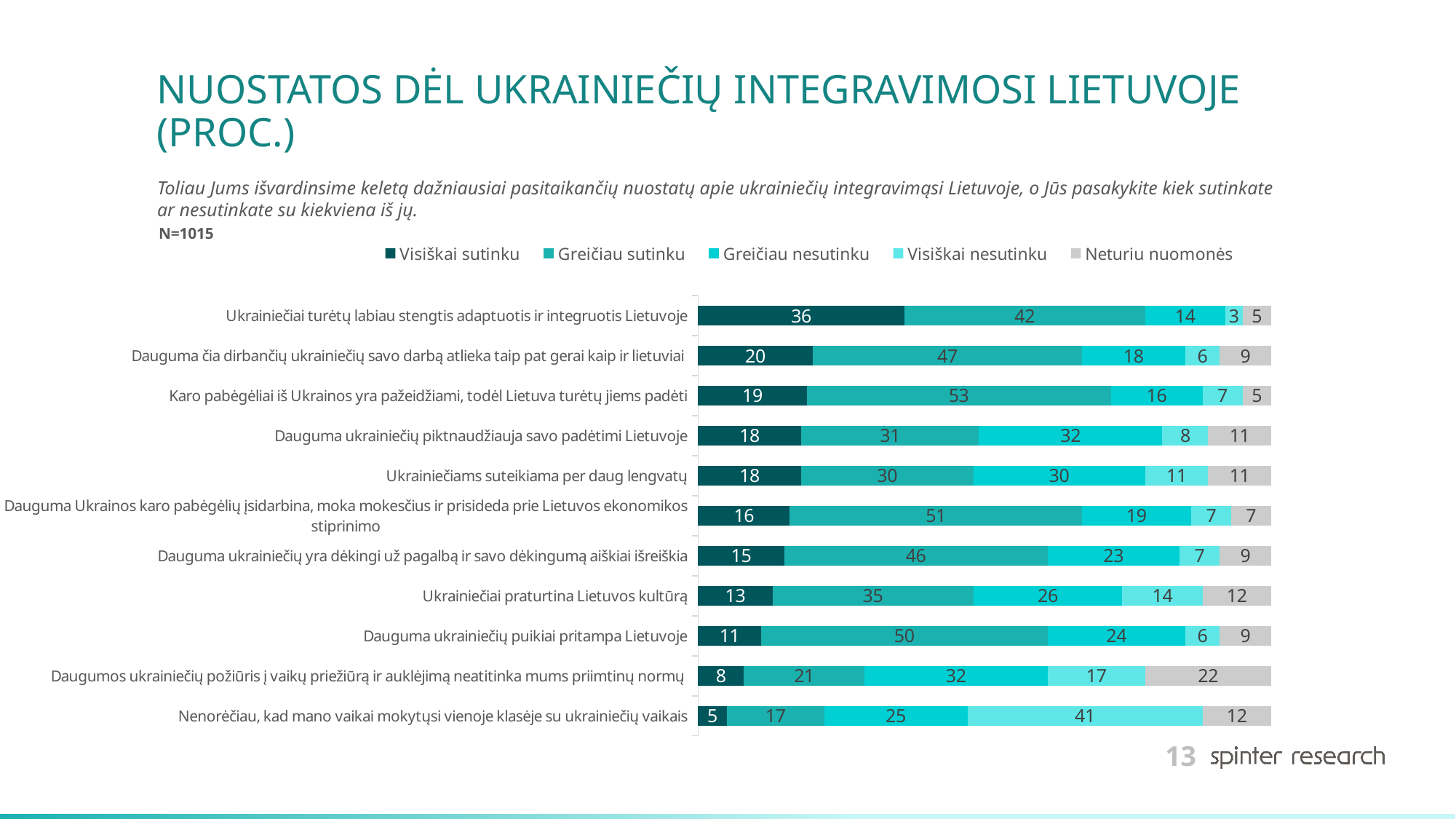
What is the "Greičiau sutinku" value for "Karo pabėgėliai iš Ukrainos yra pažeidžiami, todėl Lietuva turėtų jiems padėti"? 53 Which statement has the highest "Visiškai sutinku" value? Ukrainiečiai turėtų labiau stengtis adaptuotis ir integruotis Lietuvoje What is the "Neturiu nuomonės" value for "Daugumos ukrainiečių požiūris į vaikų priežiūrą ir auklėjimą neatitinka mums priimtinų normų"? 22 What is the "Visiškai sutinku" value for "Ukrainiečiai turėtų labiau stengtis adaptuotis ir integruotis Lietuvoje"? 36 Which statement has the lowest "Visiškai sutinku" value? Nenorėčiau, kad mano vaikai mokytųsi vienoje klasėje su ukrainiečių vaikais What is the total of the stacked bar for "Dauguma čia dirbančių ukrainiečių savo darbą atlieka taip pat gerai kaip ir lietuviai"? 100 What is the "Visiškai nesutinku" value for "Nenorėčiau, kad mano vaikai mokytųsi vienoje klasėje su ukrainiečių vaikais"? 41 How many series does the legend list? 5 How many statements (categories) are plotted in the chart? 11 What kind of chart is shown on the slide? Stacked bar chart Which is larger: the "Greičiau nesutinku" value for "Dauguma ukrainiečių piktnaudžiauja savo padėtimi Lietuvoje" or for "Ukrainiečiams suteikiama per daug lengvatų"? Dauguma ukrainiečių piktnaudžiauja savo padėtimi Lietuvoje What is the difference between the "Greičiau sutinku" values for "Dauguma ukrainiečių puikiai pritampa Lietuvoje" and "Ukrainiečiai praturtina Lietuvos kultūrą"? 15